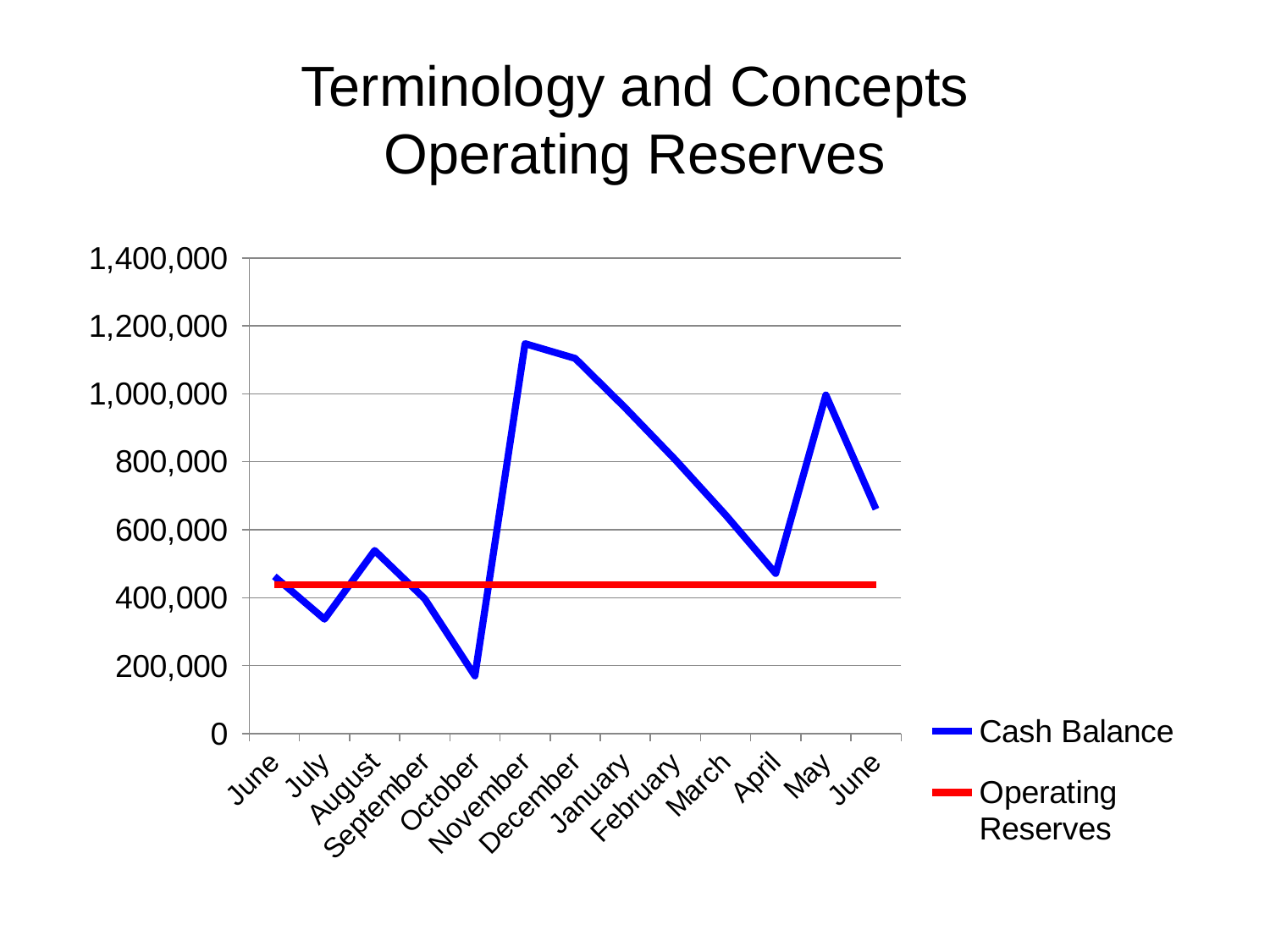
Is the Operating Reserves line greater or less than 600,000? less Is the Cash Balance for July greater or less than 400,000? less What kind of chart is shown on the slide? Line chart How many series does the legend list? 2 Which is larger, the Cash Balance in August or in July? August How many months are plotted along the x axis? 13 In which month is the Cash Balance lowest? October Which series is drawn in red? Operating Reserves In which month is the Cash Balance highest? November Does the Cash Balance rise or fall from November through April? Fall Is the Cash Balance for October greater or less than 200,000? less